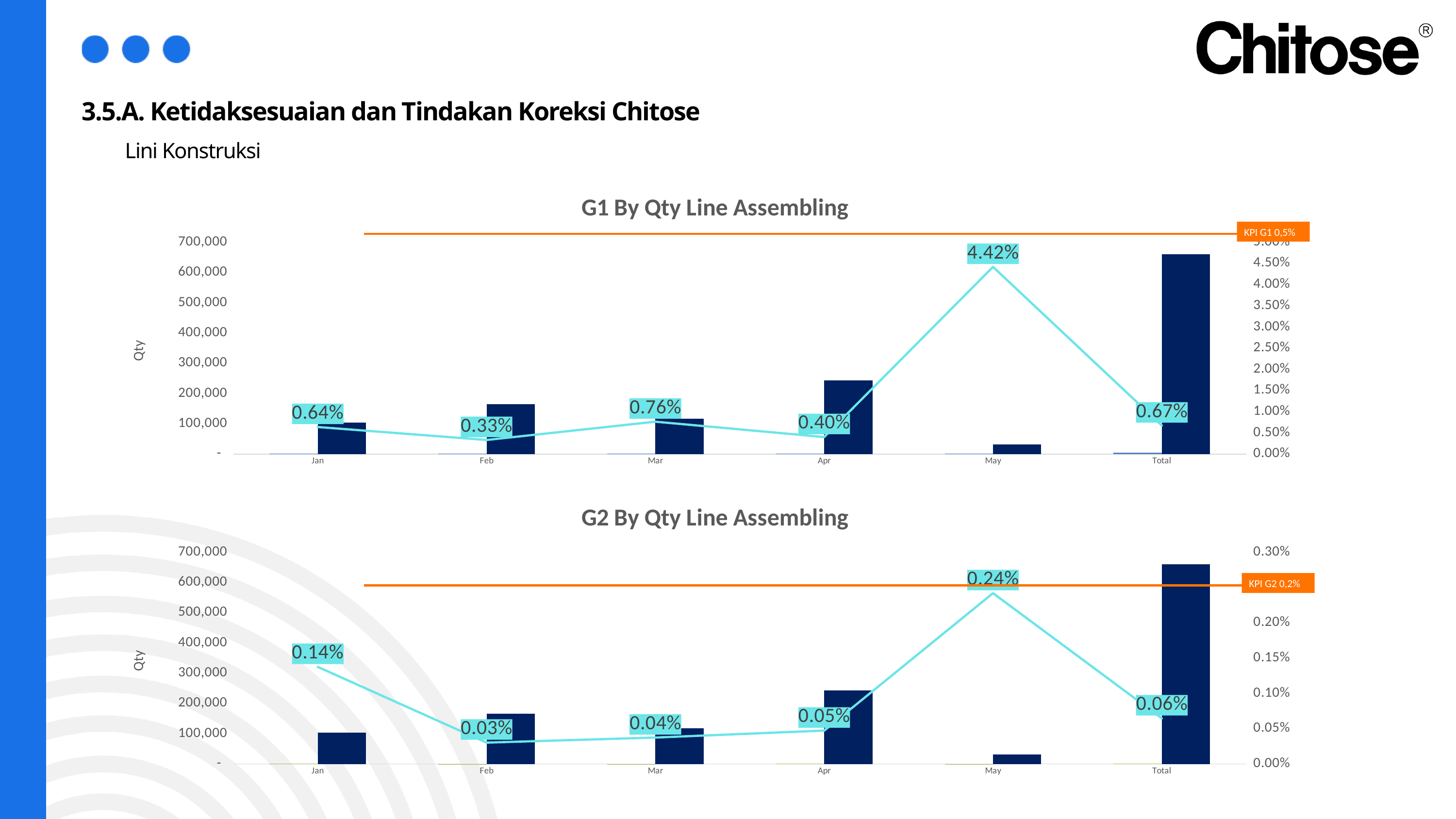
In the G1 By Qty Line Assembling chart, what is the percentage value shown for May? 4.42% In the G1 By Qty Line Assembling chart, what is the percentage value shown for Feb? 0.33% In the G1 By Qty Line Assembling chart, is the Qty bar for Total greater or less than 600,000? greater In the G2 By Qty Line Assembling chart, what is the percentage value shown for Total? 0.06% In the G2 By Qty Line Assembling chart, what is the percentage value shown for Jan? 0.14% In the G2 By Qty Line Assembling chart, which is larger, the percentage value for Jan or for Apr? Jan In the G1 By Qty Line Assembling chart, what is the difference between the percentage values for Mar and Apr? 0.36% In the G1 By Qty Line Assembling chart, is the Qty bar for May greater or less than 100,000? less What KPI value is labelled on the orange line in the G1 By Qty Line Assembling chart? KPI G1 0,5% In the G1 By Qty Line Assembling chart, which month has the highest percentage value? May In the G2 By Qty Line Assembling chart, which month has the lowest percentage value? Feb How many categories are shown on the x axis of the G2 By Qty Line Assembling chart? 6